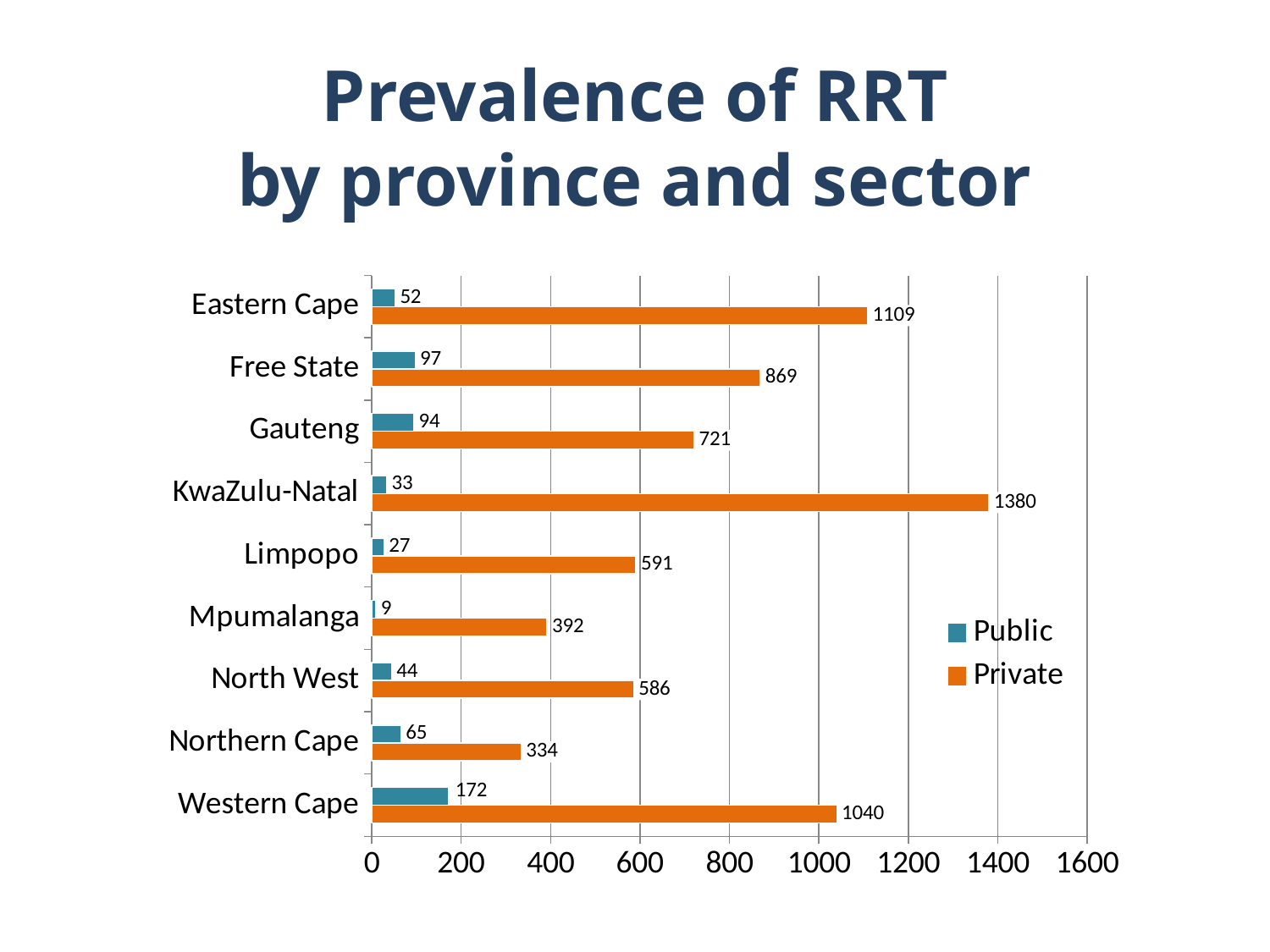
How many provinces are shown on the chart? 9 What is the Private value for KwaZulu-Natal? 1380 What is the Public value for Western Cape? 172 How many series does the legend list? 2 Which province has the highest Private value? KwaZulu-Natal What is the Private value for Northern Cape? 334 Which is larger, the Private value for Free State or the Private value for Gauteng? Free State What is the difference between the Private and Public values for Eastern Cape? 1057 What is the title of the chart? Prevalence of RRT by province and sector Which province has the lowest Public value? Mpumalanga What kind of chart is shown on the slide? Bar chart Is the Private value for Western Cape greater or less than 1000? greater